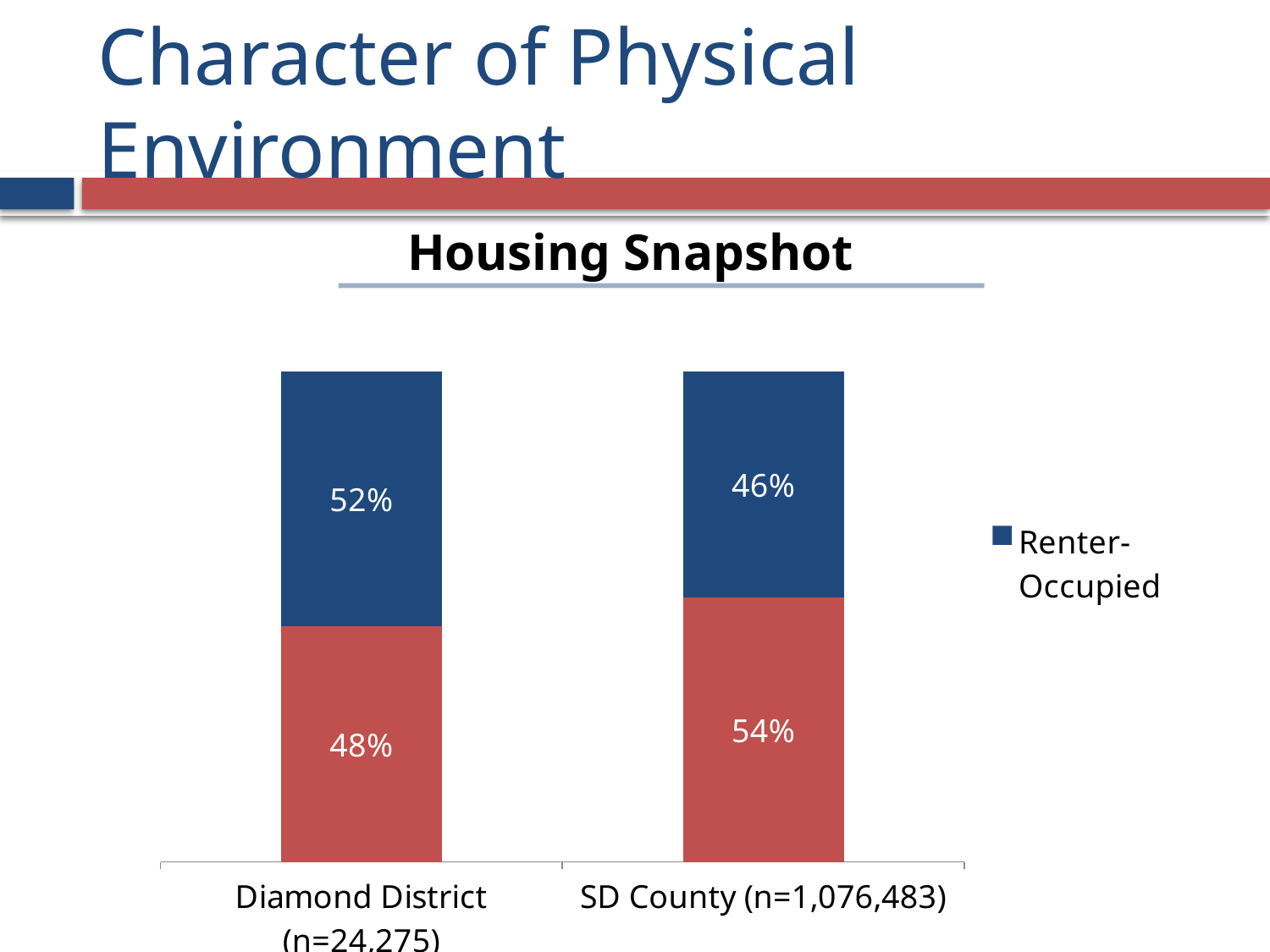
What is the Renter-Occupied percentage for Diamond District? 52% What is the title of the chart? Housing Snapshot Which has the higher Renter-Occupied percentage, Diamond District or SD County? Diamond District What percentage is shown in the red (bottom) segment of the SD County bar? 54% How many categories are shown on the x axis? 2 What type of chart is shown on the slide? Stacked bar chart Which category has the larger red (bottom) segment? SD County By how many percentage points does the Renter-Occupied share in Diamond District exceed that in SD County? 6 percentage points What is the total of the two segments in the Diamond District bar? 100% What percentage is shown in the red (bottom) segment of the Diamond District bar? 48% What is the Renter-Occupied percentage for SD County? 46% What colour represents the Renter-Occupied series? Blue